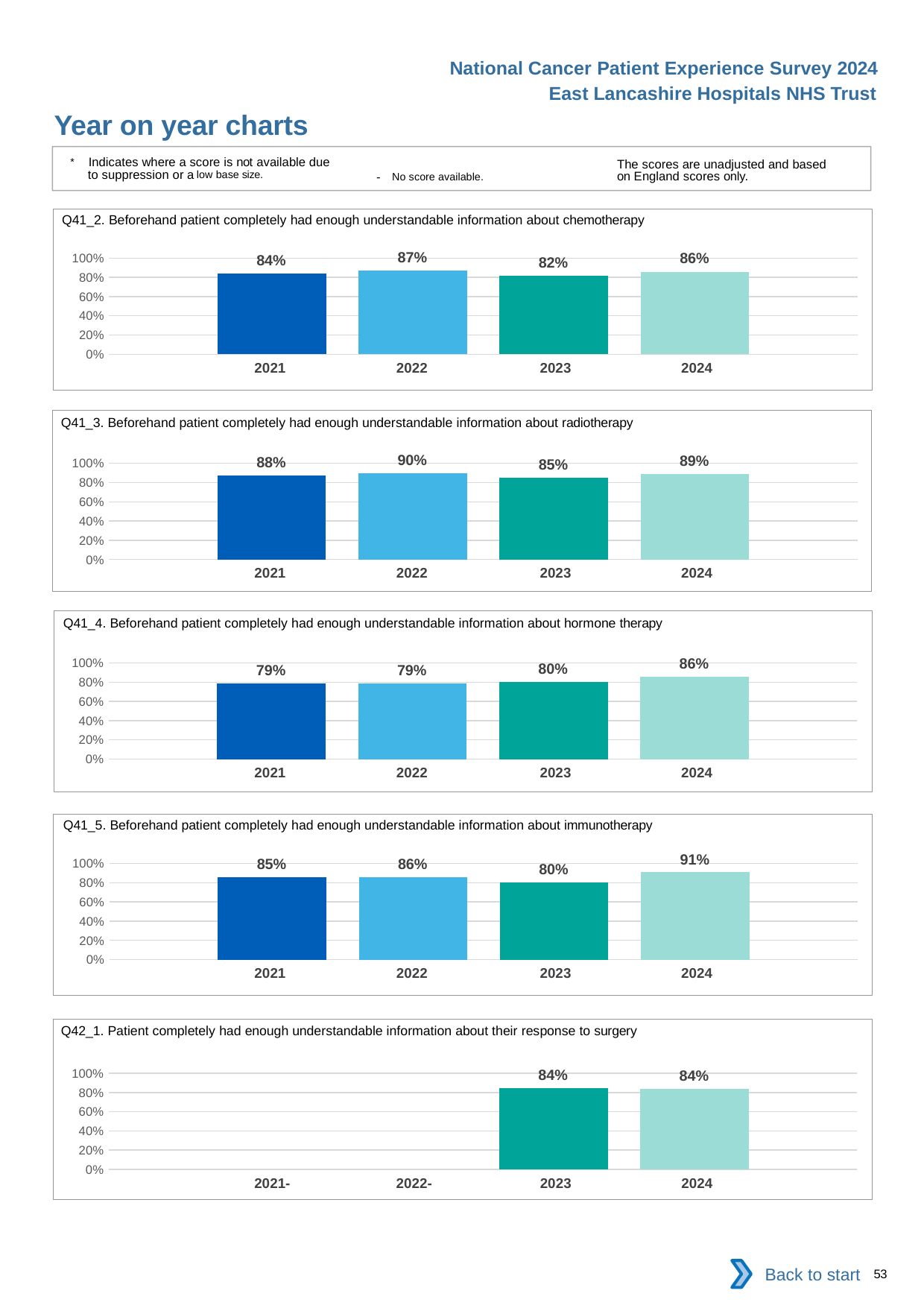
In the Q42_1 chart about response to surgery, how many years have a bar plotted? 2 In the Q41_2 chart about chemotherapy, which year has the lowest value? 2023 In the Q41_2 chart about chemotherapy, what is the value for 2022? 87% What kind of chart is the Q41_2 chart about chemotherapy? bar chart In the Q41_3 chart about radiotherapy, what is the value for 2024? 89% In the Q41_4 chart about hormone therapy, do the values rise or fall from 2021 to 2024? rise In the Q41_4 chart about hormone therapy, what is the value for 2021? 79% In the Q41_3 chart about radiotherapy, which year has the highest value? 2022 In the Q41_5 chart about immunotherapy, what is the difference between the 2024 and 2023 values? 11% In the Q42_1 chart about response to surgery, what is the value for 2023? 84% In the Q41_3 chart about radiotherapy, what is the difference between the 2022 and 2023 values? 5% In the Q41_5 chart about immunotherapy, which year has the highest value? 2024